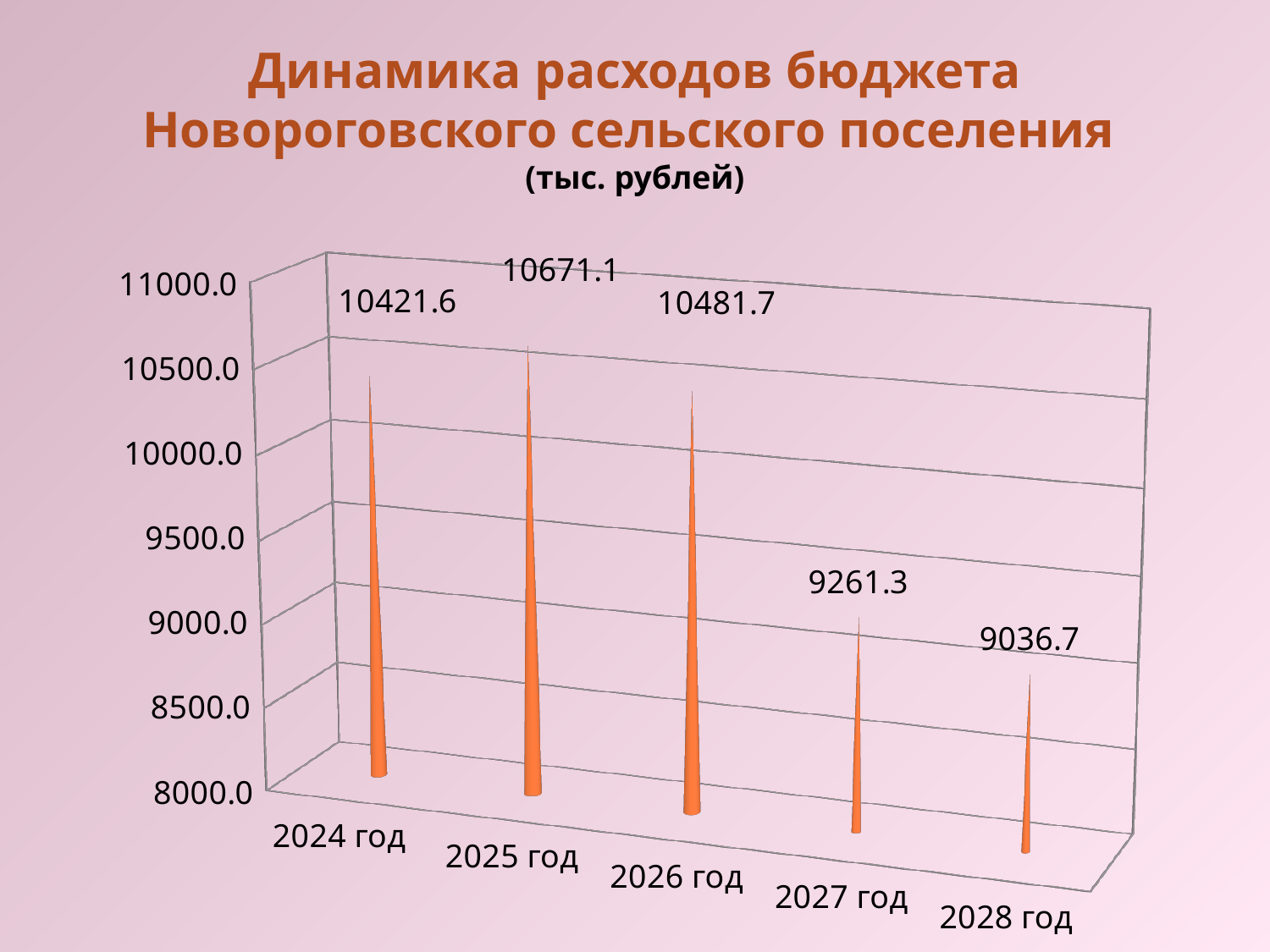
Which year has the highest value on the chart? 2025 год Which is larger, the value for 2026 год or the value for 2024 год? 2026 год What unit is given in the chart title? тыс. рублей What is the difference between the values for 2025 год and 2024 год? 249.5 Which year has the lowest value on the chart? 2028 год What is the budget expenditure value shown for 2025 год? 10671.1 Is the value for 2027 год greater or less than 9500.0? less How many years are shown on the x axis of the chart? 5 What is the difference between the values for 2027 год and 2028 год? 224.6 What is the value shown for 2028 год? 9036.7 What is the value shown for 2027 год? 9261.3 Do the values rise or fall from 2026 год to 2028 год? fall